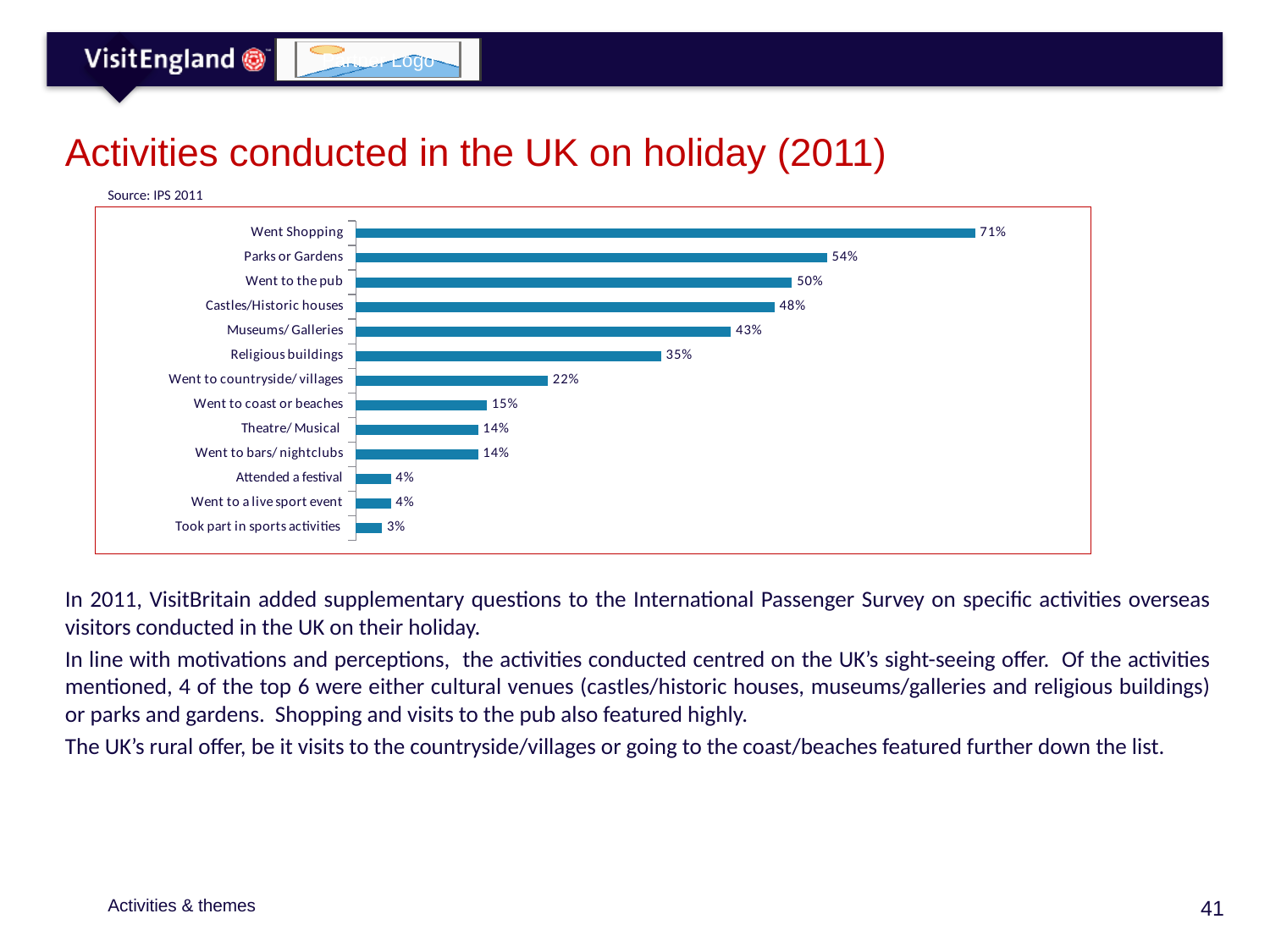
Which is larger, Went to coast or beaches or Went to countryside/ villages? Went to countryside/ villages Which activity has the highest value? Went Shopping How many activities are shown in the chart? 13 What is the source cited for the chart? IPS 2011 Which is larger, Castles/Historic houses or Museums/ Galleries? Castles/Historic houses Which activity has the lowest value? Took part in sports activities What percentage of visitors went to countryside/ villages? 22% What percentage of visitors went shopping? 71% What is the value for Museums/ Galleries? 43% What is the difference between Went Shopping and Parks or Gardens? 17% What is the difference between Went to the pub and Religious buildings? 15% What type of chart is shown on the slide? Bar chart